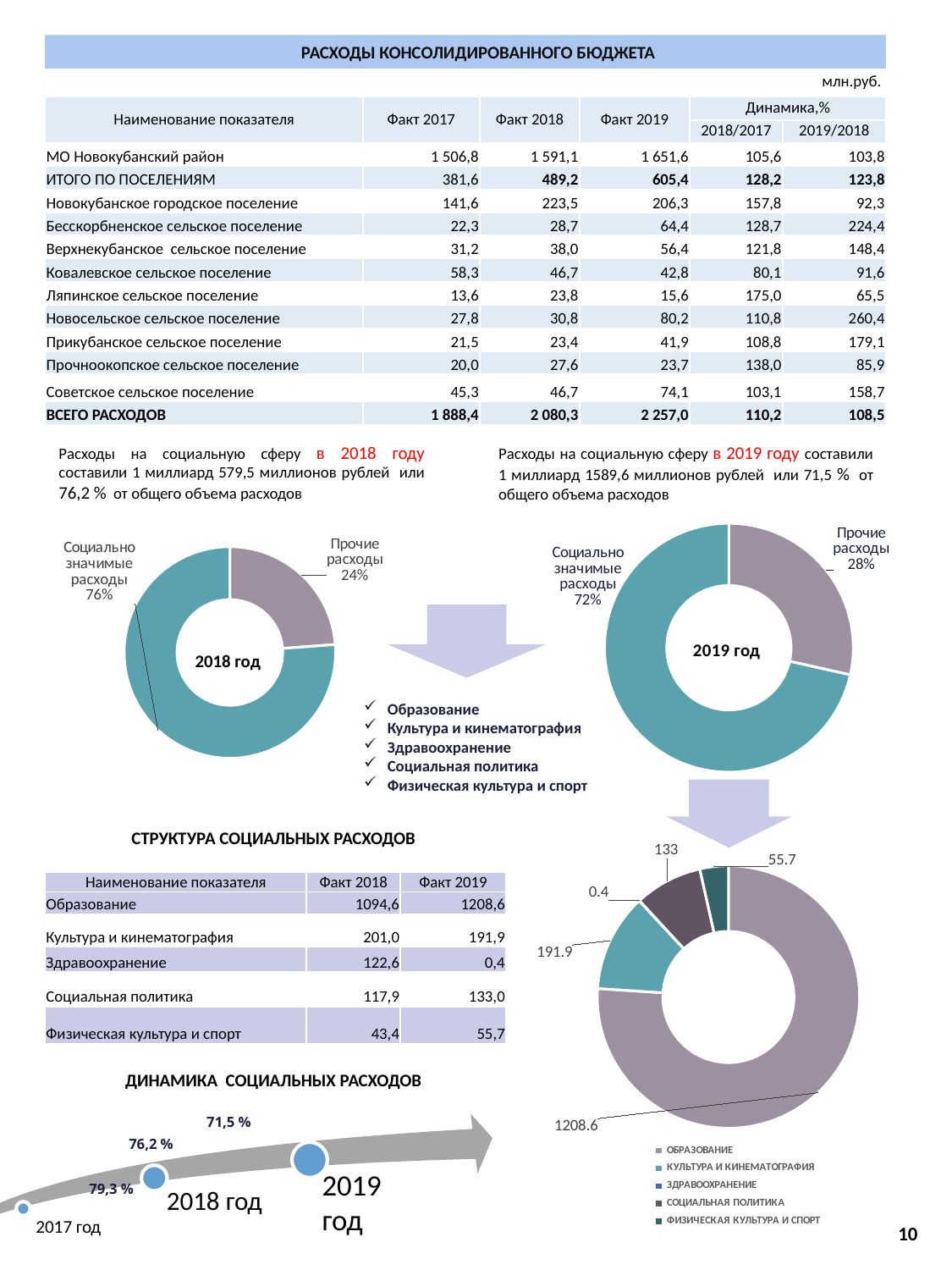
In the donut chart labelled "2019 год", which slice is larger: "Социально значимые расходы" or "Прочие расходы"? Социально значимые расходы In the bottom-right donut chart, how many categories does the legend list? 5 In the donut chart labelled "2018 год", what share is shown for "Социально значимые расходы"? 76% In the bottom-right donut chart, which category has the smallest value? ЗДРАВООХРАНЕНИЕ In the donut chart labelled "2019 год", what share is shown for "Прочие расходы"? 28% In the bottom-right donut chart, what is the difference between the values for "СОЦИАЛЬНАЯ ПОЛИТИКА" and "ФИЗИЧЕСКАЯ КУЛЬТУРА И СПОРТ"? 77.3 In the bottom-right donut chart, what value is shown for the "ОБРАЗОВАНИЕ" slice? 1208.6 In the bottom-right donut chart, what value is shown for the "КУЛЬТУРА И КИНЕМАТОГРАФИЯ" slice? 191.9 In the donut chart labelled "2018 год", what share is shown for "Прочие расходы"? 24% In the bottom-right donut chart, what value is shown for the "ФИЗИЧЕСКАЯ КУЛЬТУРА И СПОРТ" slice? 55.7 What type of chart is the chart labelled "2018 год"? Donut (pie) chart